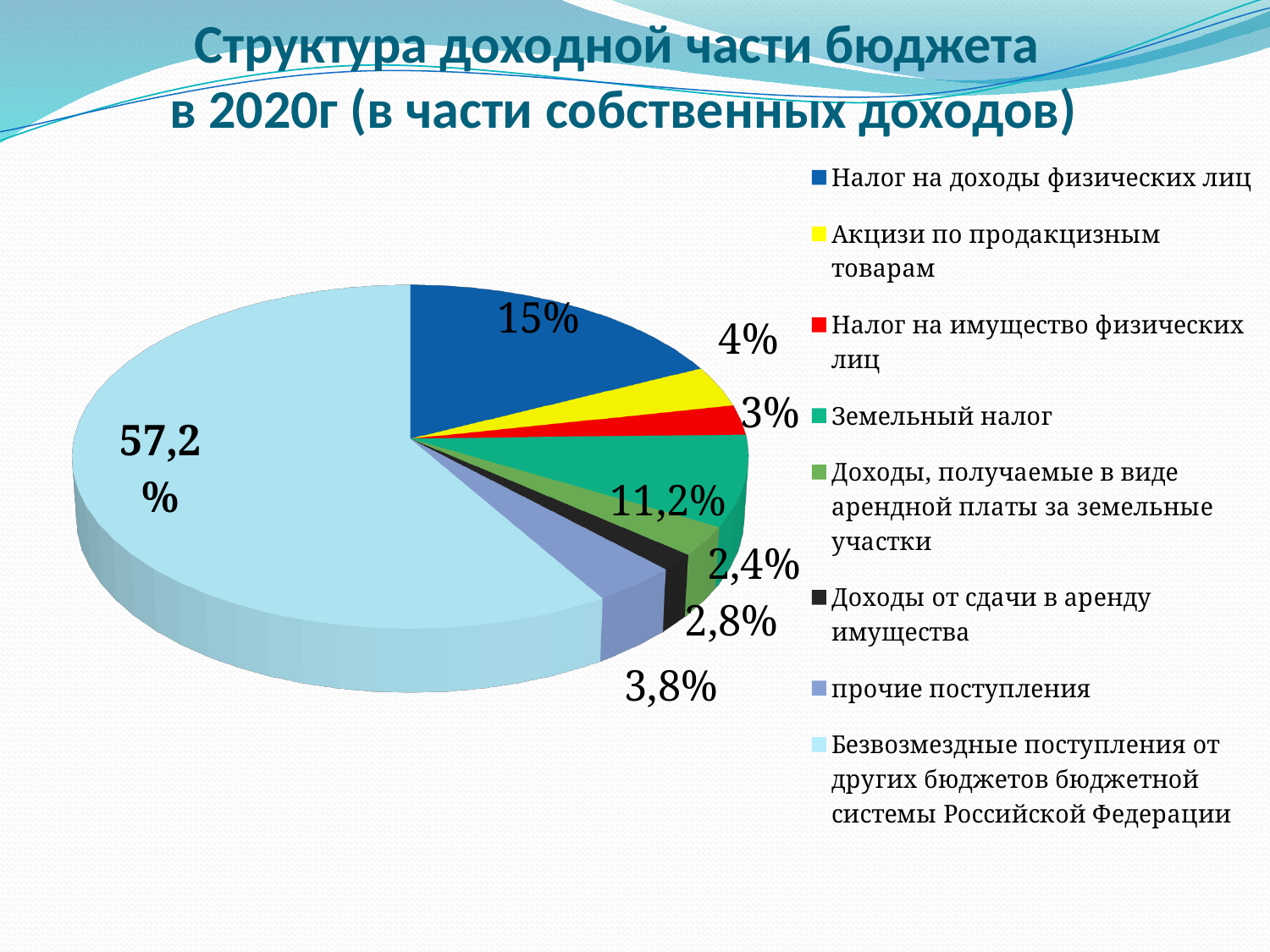
Which is larger: the share of "Акцизи по продакцизным товарам" or the share of "Налог на имущество физических лиц"? Акцизи по продакцизным товарам What share of the pie does "Земельный налог" have? 11,2% Which category has the largest slice of the pie? Безвозмездные поступления от других бюджетов бюджетной системы Российской Федерации What share of the pie does "Безвозмездные поступления от других бюджетов бюджетной системы Российской Федерации" have? 57,2% What kind of chart is shown on the slide? pie chart What is the difference between the share of "Налог на доходы физических лиц" and the share of "Земельный налог"? 3,8% What share of the pie does "прочие поступления" have? 3,8% What colour is the slice for "Земельный налог"? green What share of the pie does "Налог на доходы физических лиц" have? 15% How many categories does the legend of the pie chart list? 8 What share of the pie does "Доходы от сдачи в аренду имущества" have? 2,8%